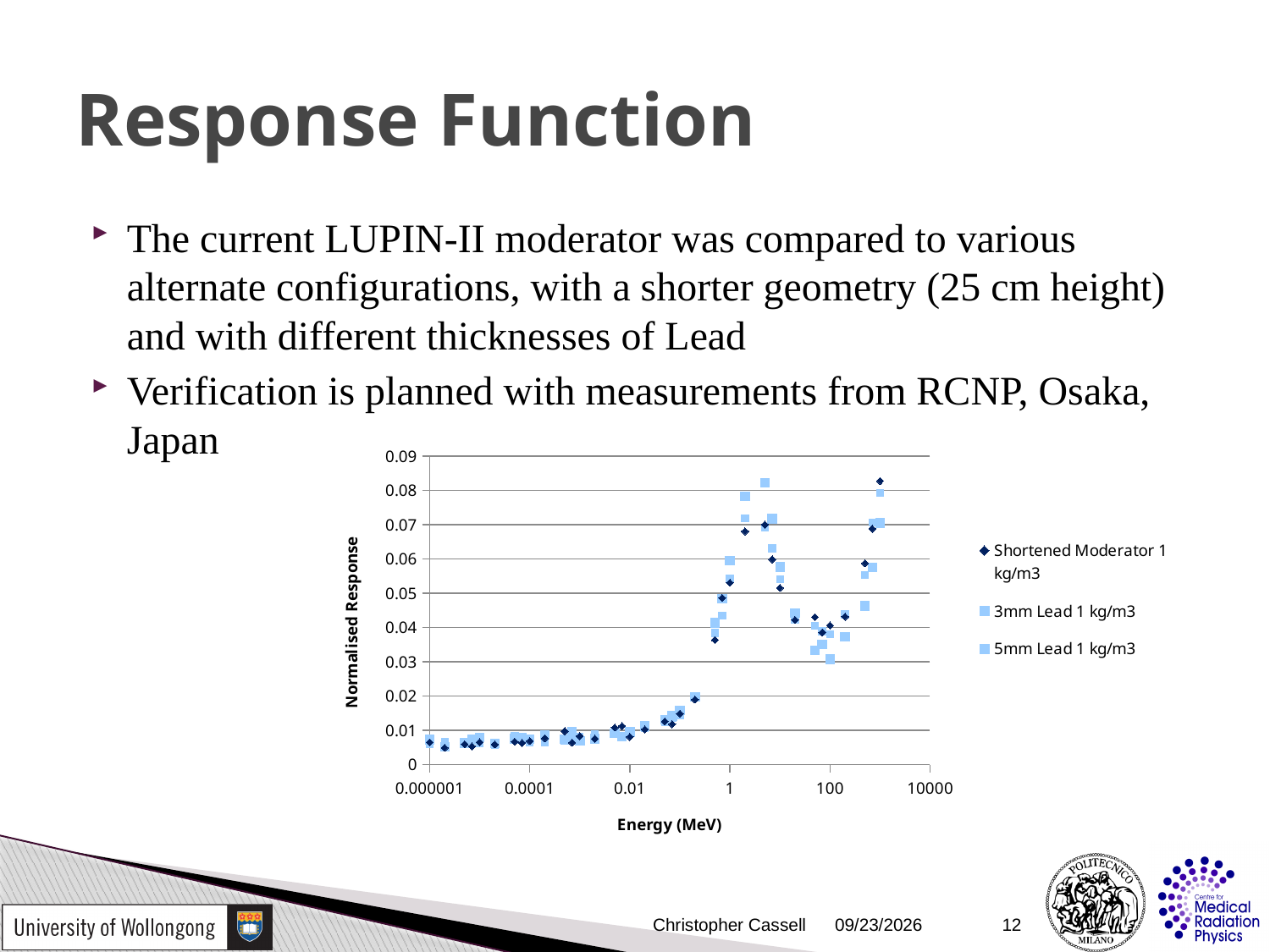
Is the highest value plotted for the 3mm Lead 1 kg/m3 series greater or less than 0.07? greater Is the highest value plotted on the chart greater or less than 0.09? less What kind of chart is shown on the slide? scatter chart What is the title of the x axis of the chart? Energy (MeV) How many series does the chart legend list? 3 Is the value for the Shortened Moderator 1 kg/m3 series at around 0.1 MeV greater or less than 0.03? less What is the title of the y axis of the chart? Normalised Response Do the plotted values generally rise or fall as energy increases along the x axis? rise What is the highest tick value shown on the y axis? 0.09